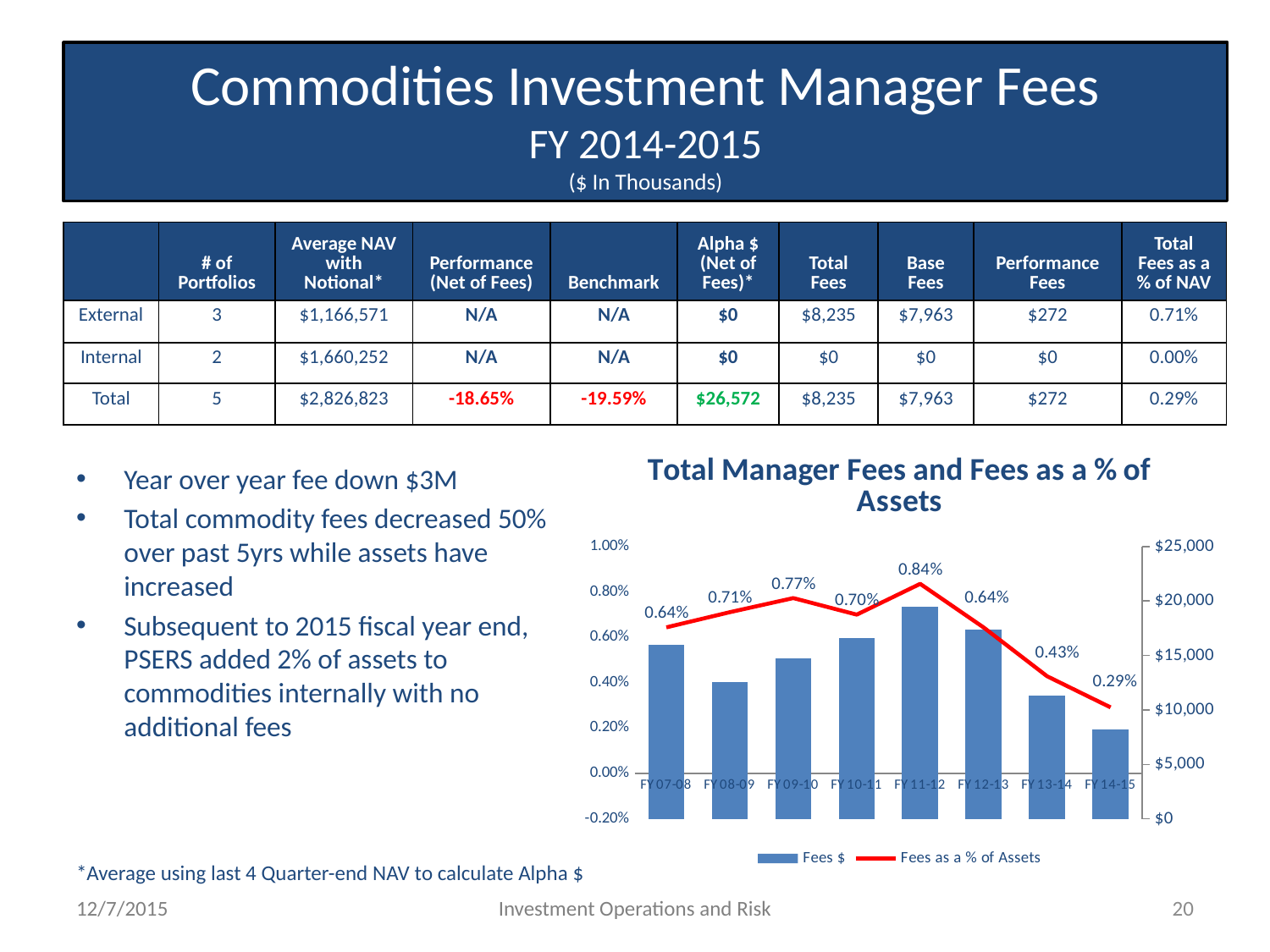
Is the Fees $ bar for FY 11-12 greater or less than $15,000? greater What is the title of the chart on the slide? Total Manager Fees and Fees as a % of Assets What is the value of Fees as a % of Assets for FY 14-15? 0.29% What is the difference between the highest and lowest Fees as a % of Assets values? 0.55% How many fiscal years are shown on the x axis of the chart? 8 How many series does the chart legend list? 2 What is the value of Fees as a % of Assets for FY 11-12? 0.84% Which fiscal year has the highest Fees as a % of Assets? FY 11-12 What type of chart is shown on the slide? Combined bar and line chart Which fiscal year has the lowest Fees as a % of Assets? FY 14-15 Which is larger, Fees as a % of Assets for FY 09-10 or for FY 10-11? FY 09-10 Is the Fees $ bar for FY 14-15 greater or less than $10,000? less